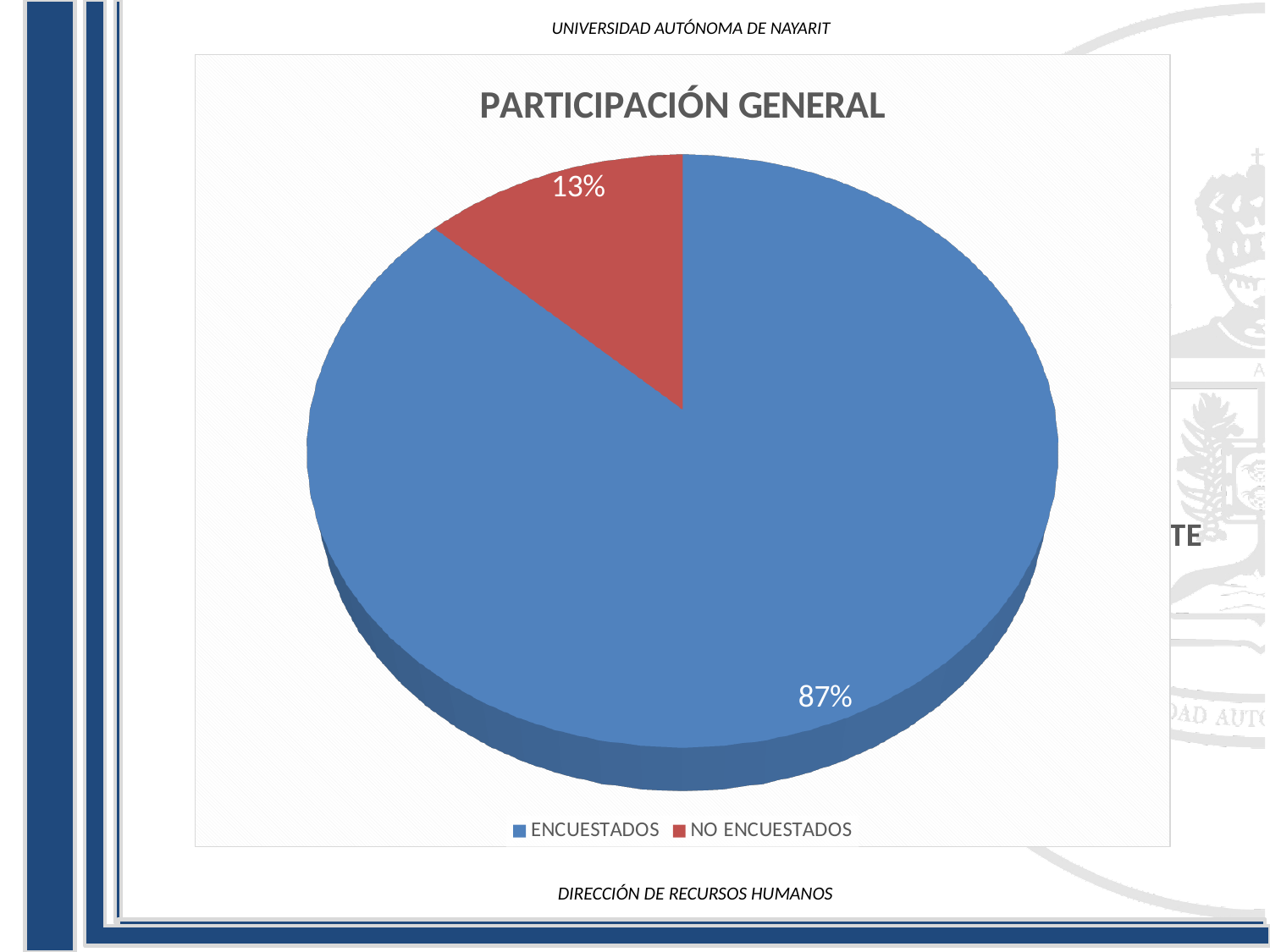
What kind of chart is shown on the slide? Pie chart Which is larger, the share for ENCUESTADOS or the share for NO ENCUESTADOS? ENCUESTADOS Which category has the largest share of the pie? ENCUESTADOS What is the share of the pie for the blue slice? 87% What colour is the slice for NO ENCUESTADOS? Red What is the title of the chart? PARTICIPACIÓN GENERAL What percentage of the pie does NO ENCUESTADOS represent? 13% How many entries does the legend list? 2 What is the difference in percentage points between ENCUESTADOS and NO ENCUESTADOS? 74 Which category has the smallest share of the pie? NO ENCUESTADOS How many categories are shown in the pie chart? 2 What percentage of the pie does ENCUESTADOS represent? 87%